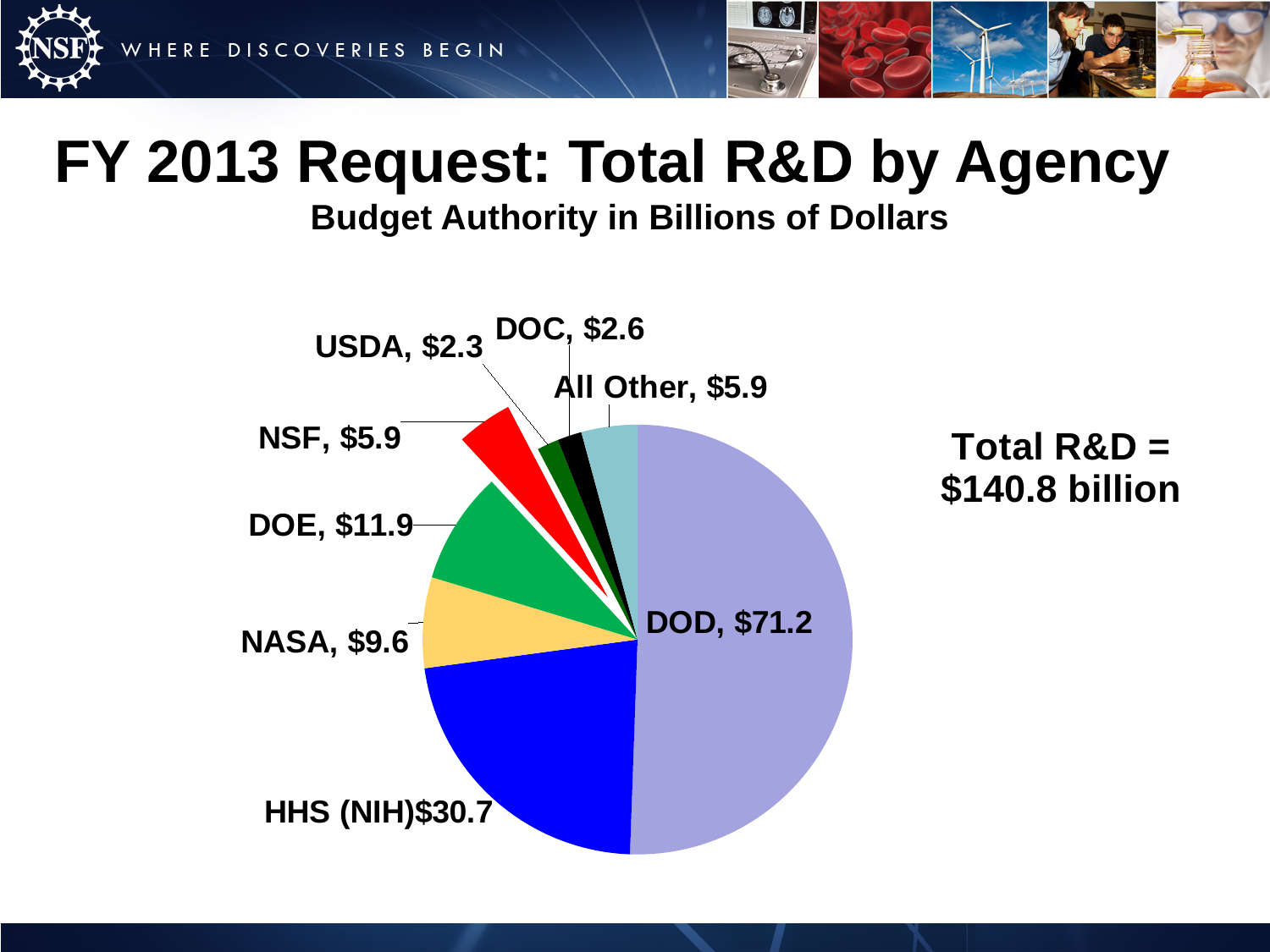
What is the difference between the DOD and HHS (NIH) values? $40.5 What is the FY 2013 R&D budget authority requested for DOD? $71.2 What total R&D amount is stated next to the pie chart? $140.8 billion Which is larger, the value for NASA or the value for DOE? DOE What is the difference between the DOE and NASA values? $2.3 What is the value shown for HHS (NIH)? $30.7 What is the value shown for DOE? $11.9 What is the value shown for NSF? $5.9 Which agency has the smallest slice of the pie? USDA What type of chart is shown on the slide? Pie chart Which agency has the largest slice of the pie? DOD How many slices does the pie chart have? 8